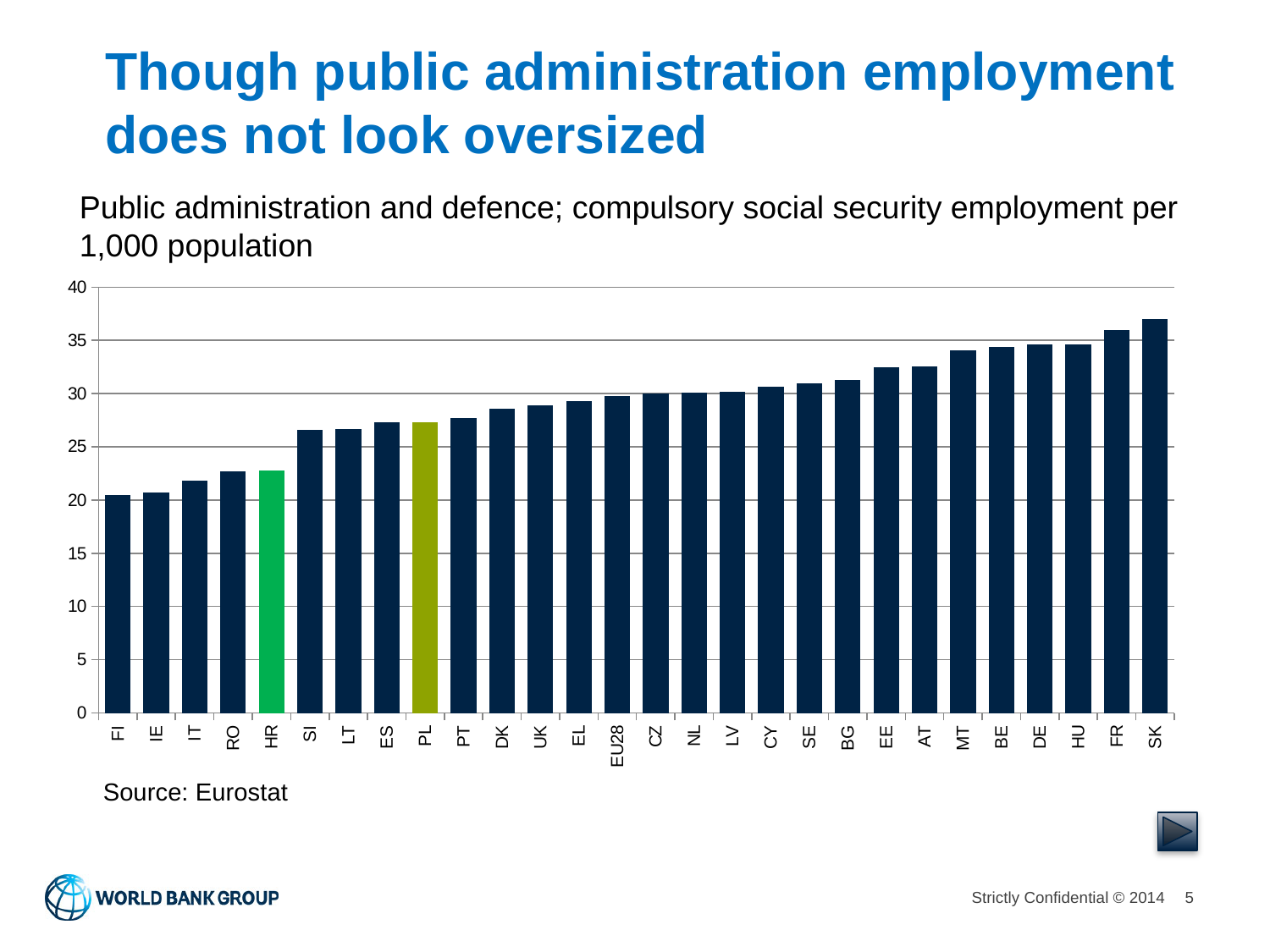
Which category has the lowest value? FI What kind of chart is shown on the slide? bar chart Which is larger, the value for HR or the value for EU28? EU28 Which two categories are highlighted with a different bar colour from the rest? HR and PL Is the value for SK greater or less than 35? greater Do the values generally rise or fall from left to right along the x axis? rise Is the value for EU28 greater or less than 25? greater How many categories are plotted along the x axis? 28 Which category has the highest value? SK Which is larger, the value for FR or the value for IT? FR Is the value for FI greater or less than 25? less